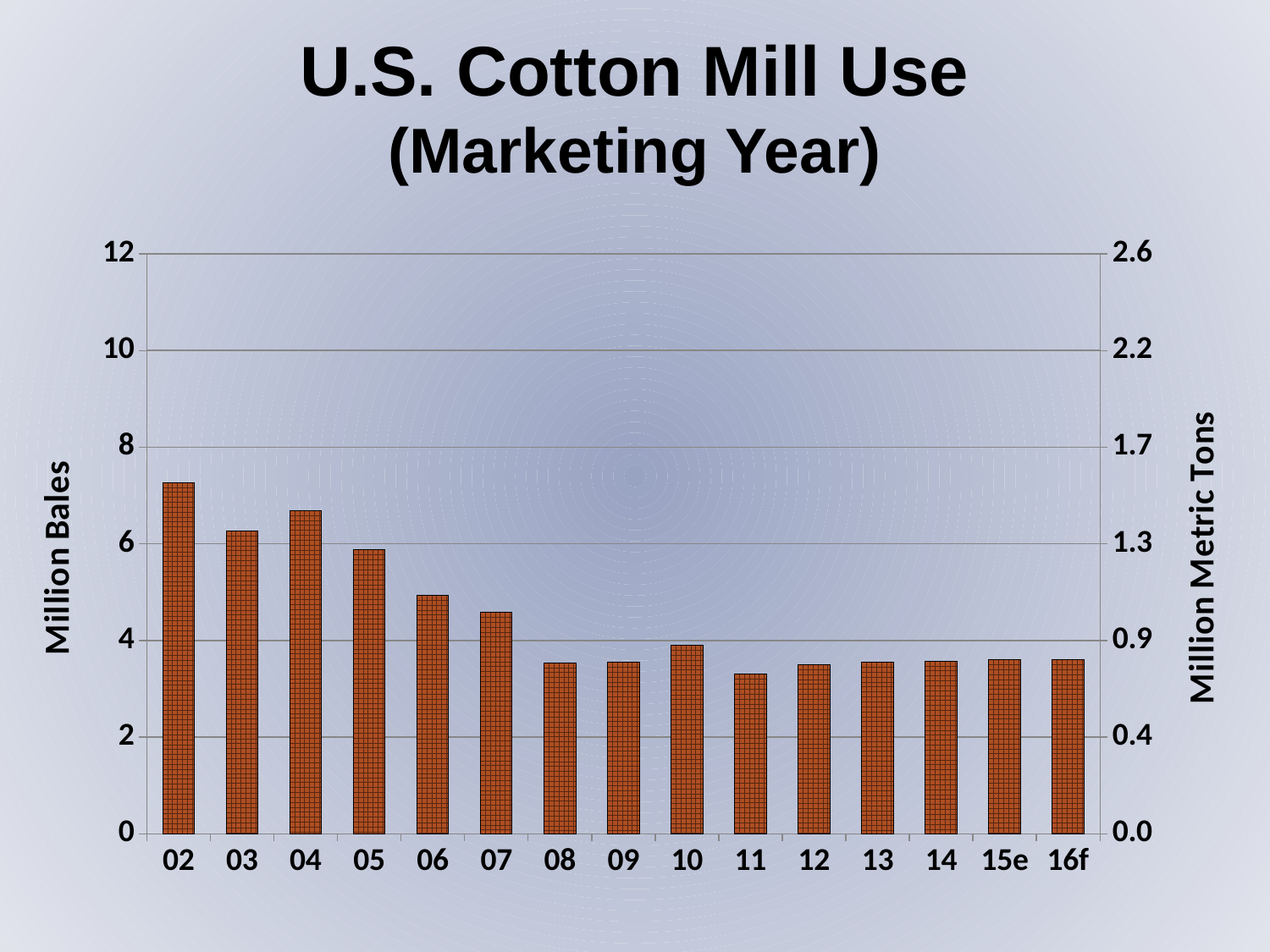
Is the value for 08 greater or less than 4 million bales? less Is the value for 11 greater or less than 4 million bales? less Which is larger, the value for 03 or the value for 04? 04 Overall, do the values rise or fall from 02 to 16f? fall Which is larger, the value for 05 or the value for 06? 05 Is the value for 06 greater or less than 4 million bales? greater What is the label on the left vertical axis? Million Bales How many marketing years are plotted on the chart? 15 What kind of chart is shown on the slide? bar chart Which marketing year has the highest cotton mill use? 02 Which marketing year has the lowest cotton mill use? 11